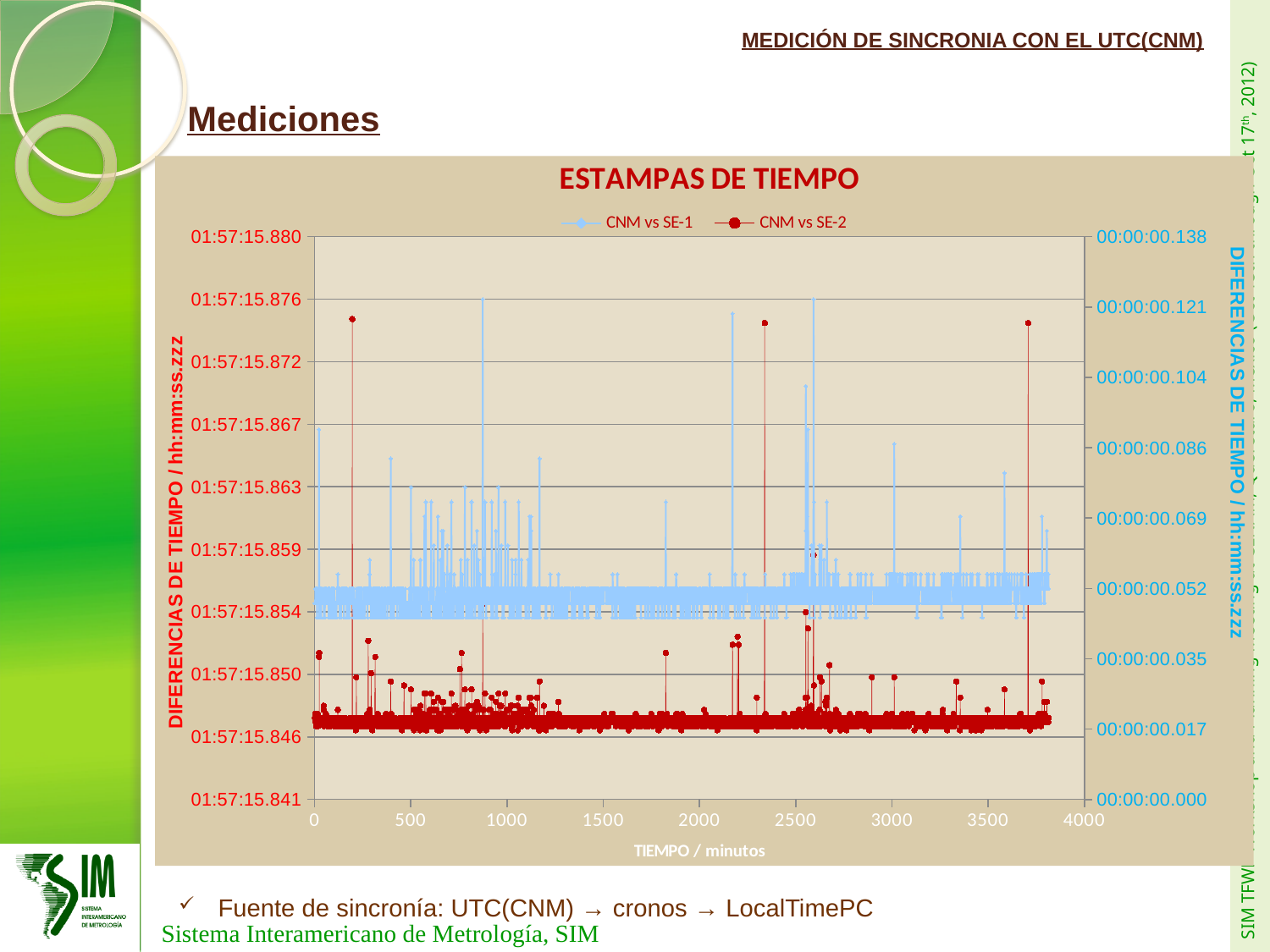
What is the highest tick value shown on the x axis? 4000 How many series does the chart's legend list? 2 Are the typical values of the CNM vs SE-1 series greater or less than 01:57:15.863 on the left axis? less What is the topmost tick value on the right y axis? 00:00:00.138 What is the title of the chart? ESTAMPAS DE TIEMPO What is the lowest tick value on the left y axis? 01:57:15.841 What is the topmost tick value on the left y axis? 01:57:15.880 Which series generally has the higher values, CNM vs SE-1 or CNM vs SE-2? CNM vs SE-1 What kind of chart is shown on the slide? Line chart What are the names of the two series in the legend? CNM vs SE-1 and CNM vs SE-2 What is the label of the x axis? TIEMPO / minutos